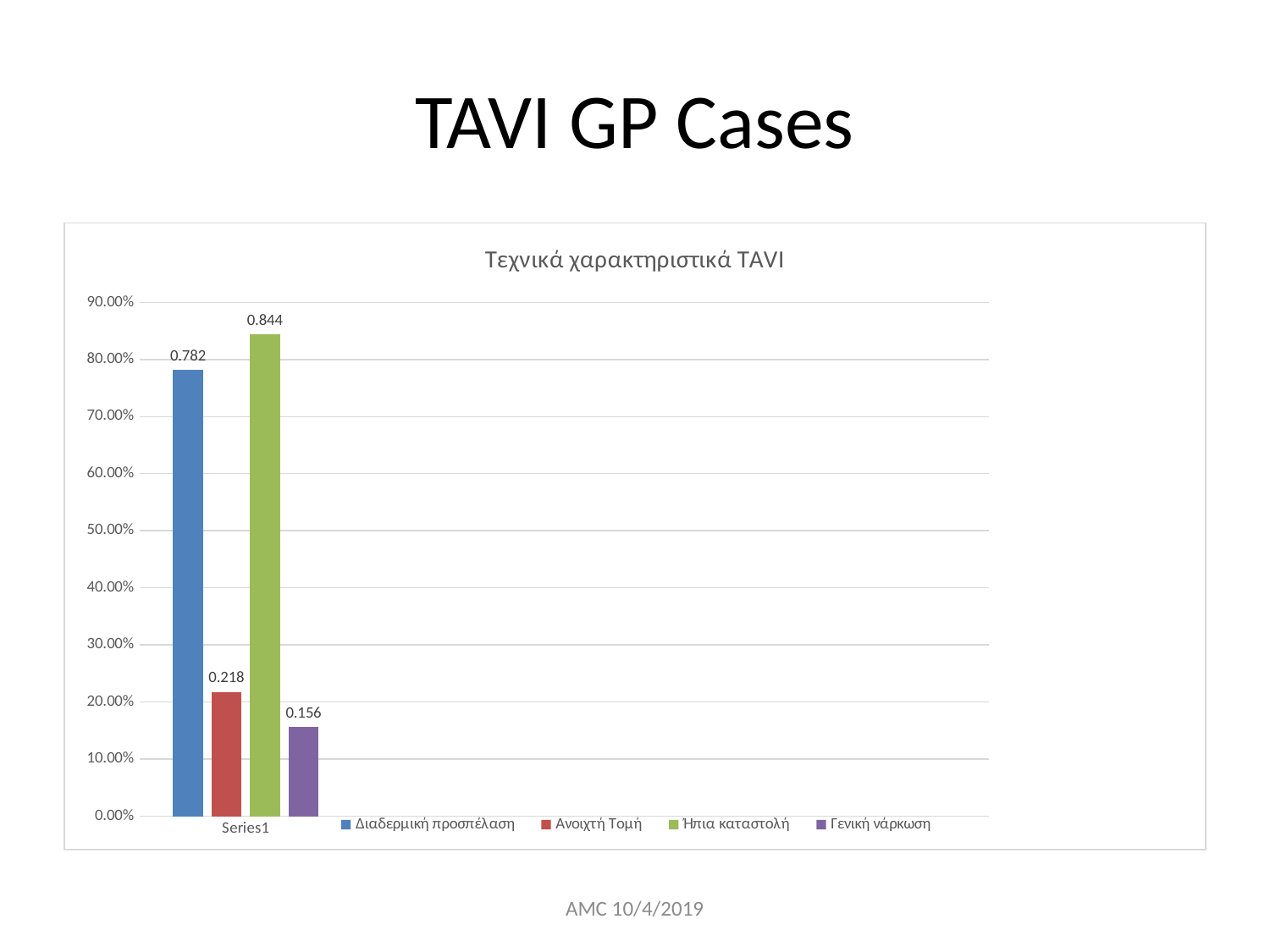
What is the value for Γενική νάρκωση? 0.156 What is the value for Ήπια καταστολή? 0.844 Which is larger, the value for Ανοιχτή Τομή or the value for Γενική νάρκωση? Ανοιχτή Τομή What is the value for Ανοιχτή Τομή? 0.218 Which series has the lowest value? Γενική νάρκωση How many series does the legend list? 4 What is the difference between the values for Ήπια καταστολή and Διαδερμική προσπέλαση? 0.062 What is the value for Διαδερμική προσπέλαση? 0.782 Is the value for Γενική νάρκωση greater or less than 20.00%? less What kind of chart is shown on the slide? bar chart Which series has the highest value? Ήπια καταστολή What is the difference between the values for Διαδερμική προσπέλαση and Ανοιχτή Τομή? 0.564